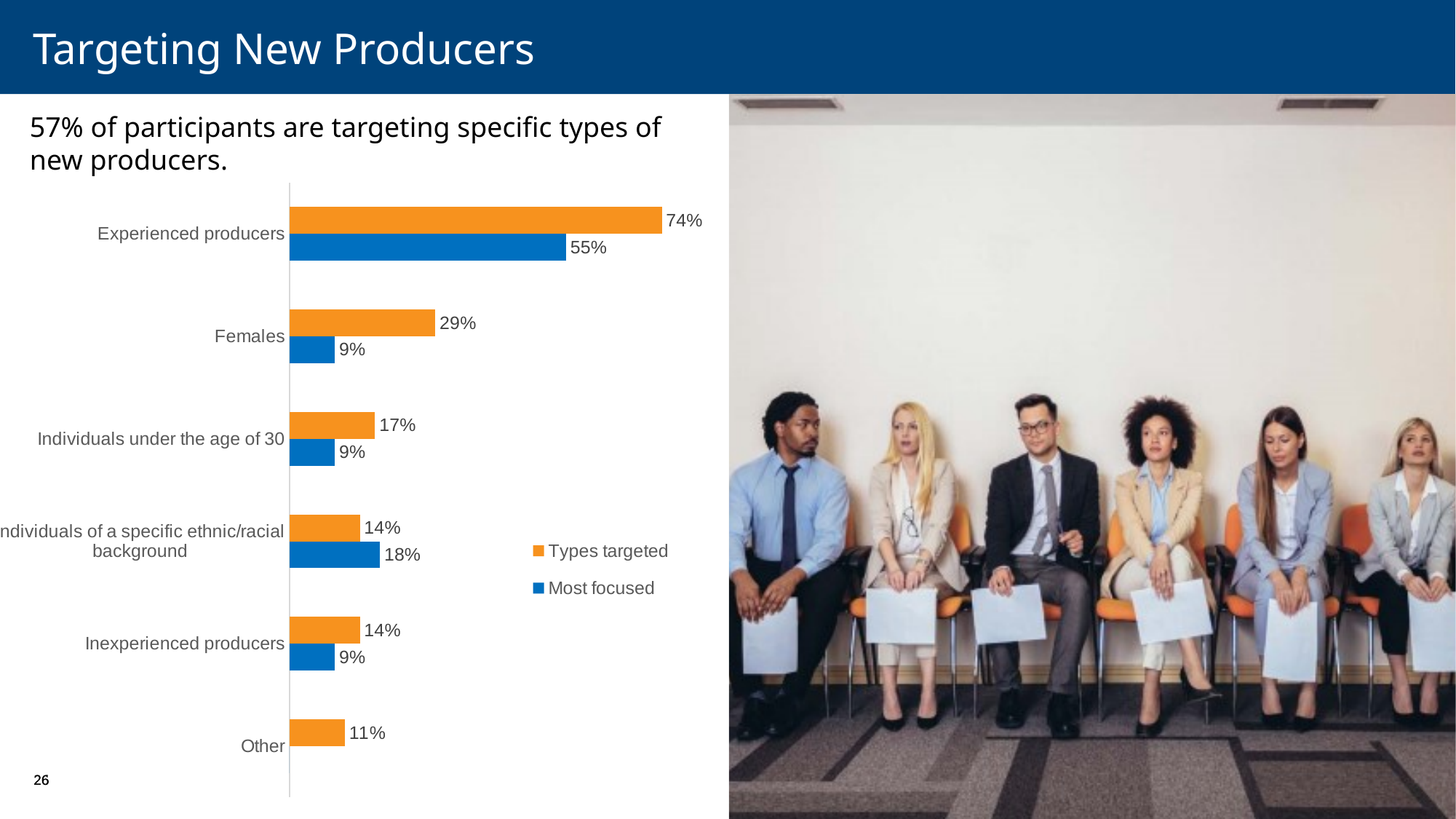
What is the Most focused value for Females? 9% What is the Types targeted value for Individuals under the age of 30? 17% What kind of chart is shown on the slide? Bar chart Which category has the highest Types targeted value? Experienced producers What is the difference between the Types targeted and Most focused values for Experienced producers? 19% How many series does the legend list? 2 Which colour represents the Most focused series? Blue What is the Most focused value for Individuals of a specific ethnic/racial background? 18% Which category has the lowest Types targeted value? Other For Individuals of a specific ethnic/racial background, which is larger: Types targeted or Most focused? Most focused How many categories are shown on the chart? 6 What percentage of participants target experienced producers (Types targeted)? 74%